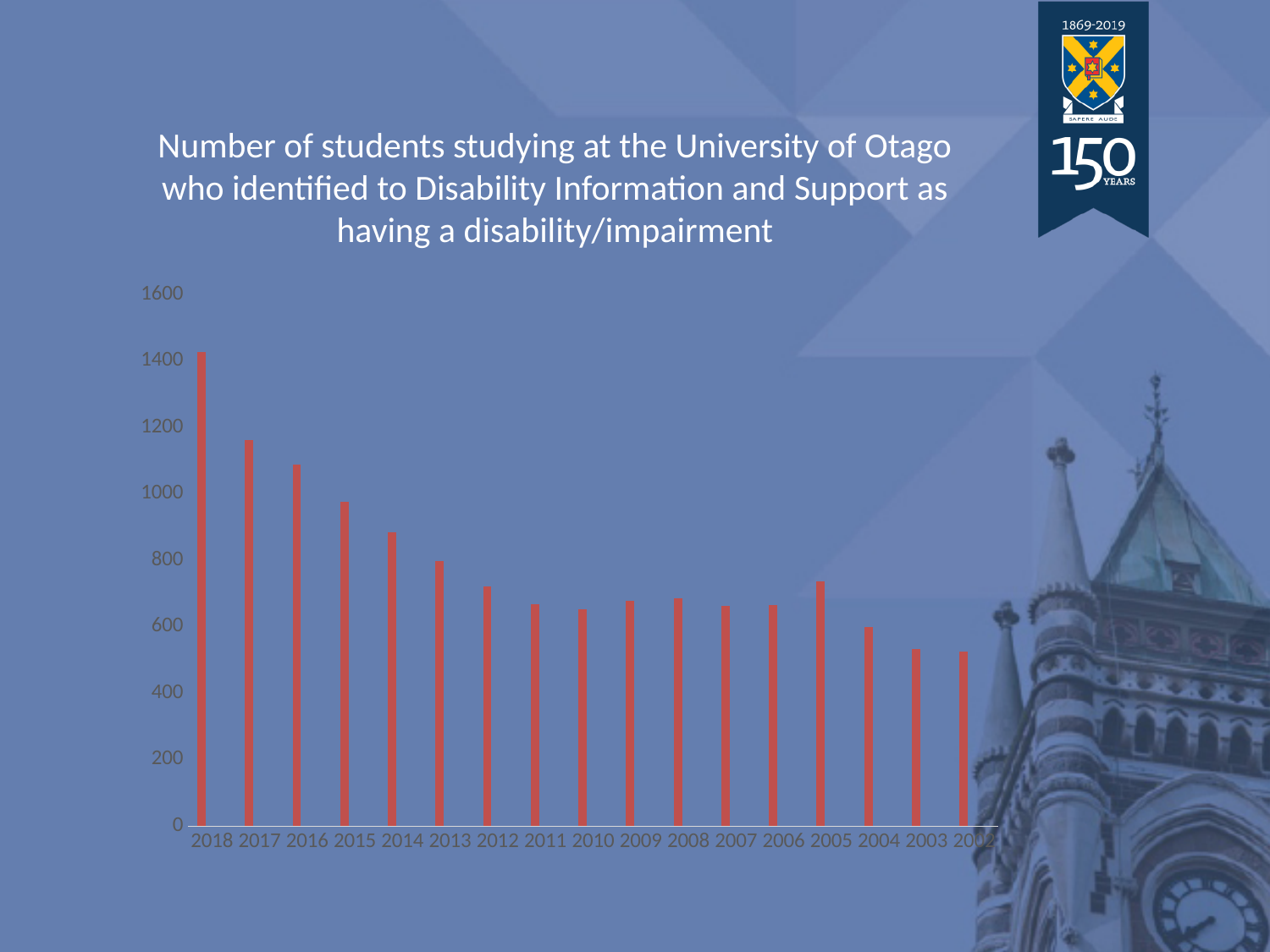
Which year has the larger value, 2005 or 2004? 2005 Is the value for 2014 greater or less than 800? greater Which year has the highest number of students identified as having a disability/impairment? 2018 Is the value for 2003 greater or less than 600? less Is the value for 2018 greater or less than 1200? greater Which year has the larger value, 2018 or 2017? 2018 Moving from left (2018) to right (2002) along the x axis, do the values generally rise or fall? fall How many years (bars) are plotted on the chart? 17 What kind of chart is shown on the slide? bar chart